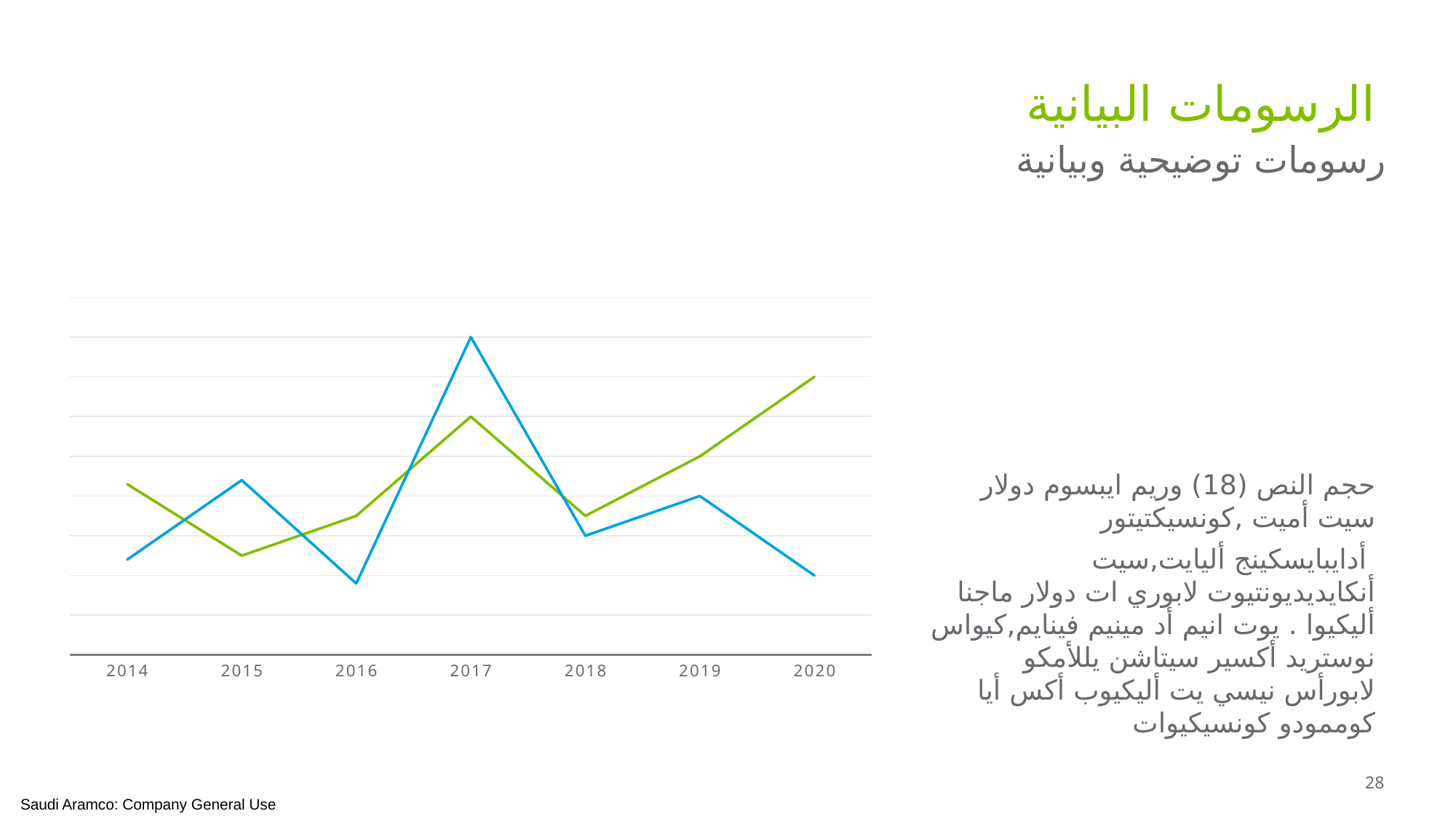
What is the first year shown on the x axis of the chart? 2014 In 2015, which line is higher, the blue line or the green line? blue line In 2017, which line is higher, the blue line or the green line? blue line Does the green line rise or fall from 2018 to 2020? rise In which year does the green line reach its lowest point? 2015 What kind of chart is shown on the slide? line chart In which year does the green line reach its highest point? 2020 In which year does the blue line reach its highest point? 2017 How many years are shown on the x axis of the chart? 7 How many lines are plotted on the chart? 2 Does the blue line rise or fall from 2017 to 2018? fall In 2020, which line is higher, the blue line or the green line? green line